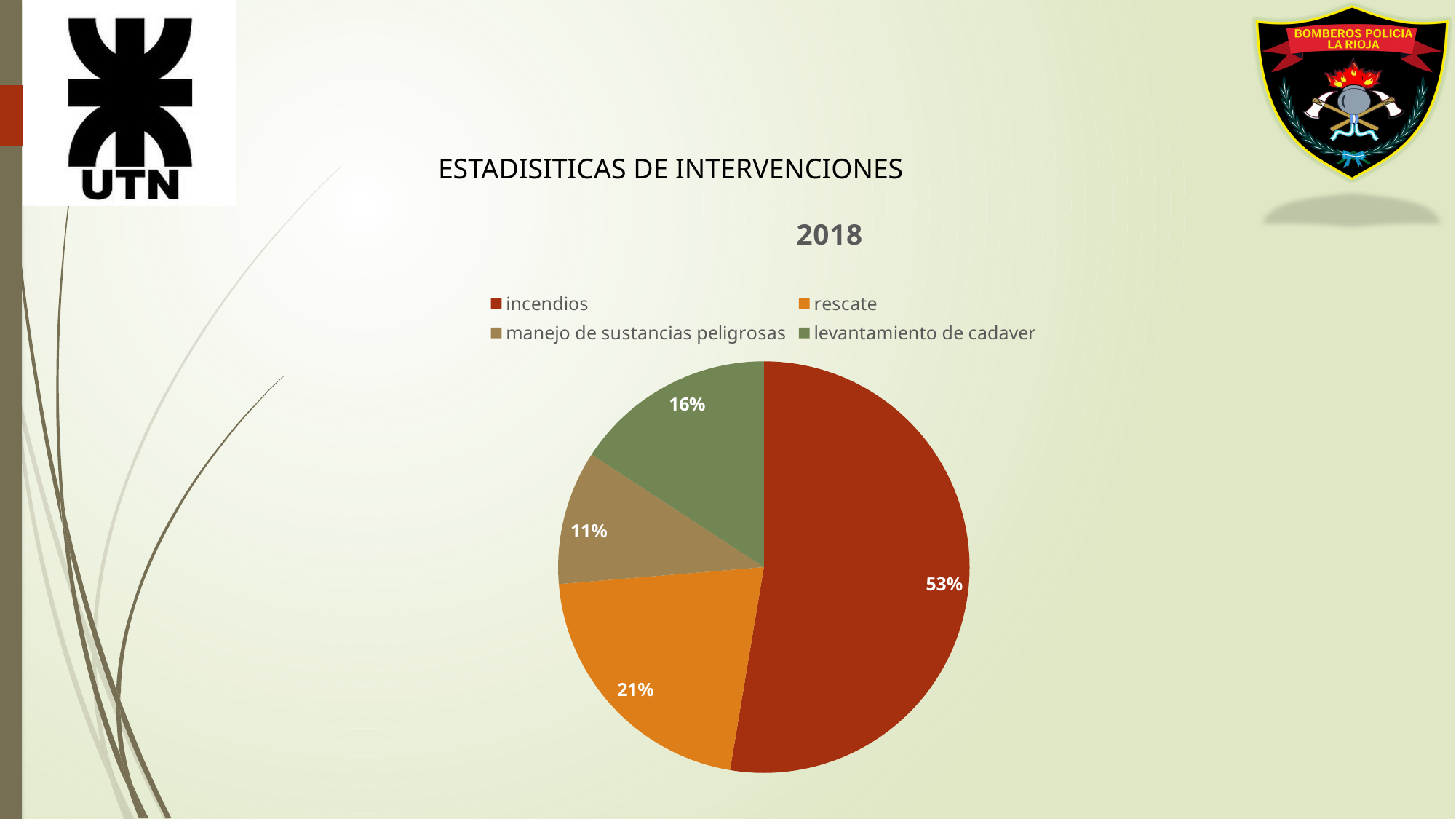
What share of the pie does rescate have? 21% Which category has the smallest slice of the pie? manejo de sustancias peligrosas What colour is the slice for levantamiento de cadaver? green What is the difference in percentage points between incendios and rescate? 32 Which category has the largest slice of the pie? incendios What share of the pie does incendios have? 53% What share of the pie does manejo de sustancias peligrosas have? 11% How many categories does the pie chart show? 4 What kind of chart is shown on the slide? pie chart What is the chart's title? 2018 Which is larger, the slice for rescate or the slice for levantamiento de cadaver? rescate